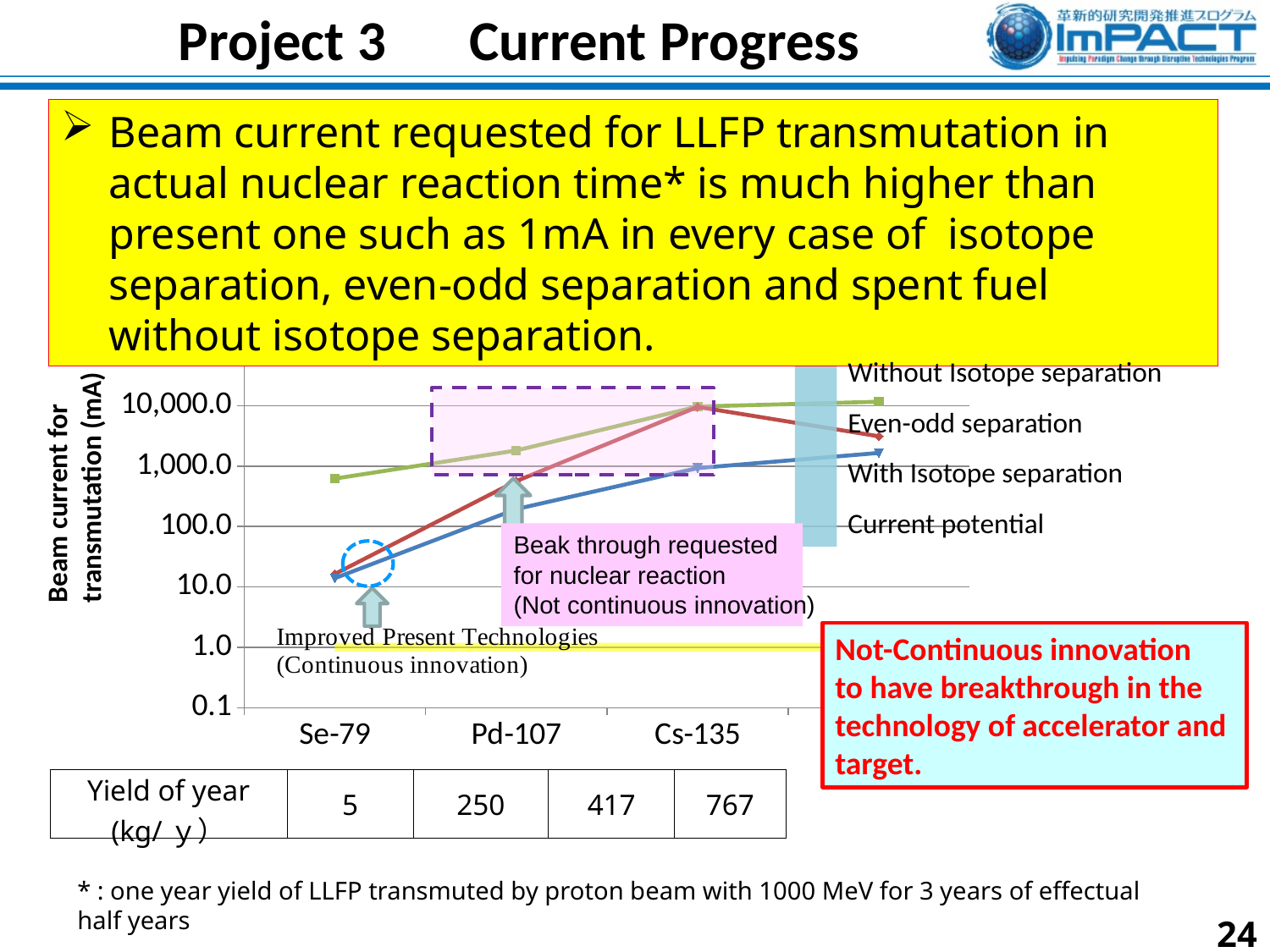
At what beam current level does the Current potential line sit on the chart? 1.0 Is the value for Even-odd separation at Pd-107 greater or less than 100.0? greater What is the label of the chart's vertical axis? Beam current for transmutation (mA) Is the value for Without Isotope separation at Se-79 greater or less than 1,000.0? less Is the value for With Isotope separation at Se-79 greater or less than 100.0? less Does the Without Isotope separation series rise or fall from Se-79 to Cs-135? rise What kind of chart is shown on the slide? line chart How many series does the chart legend list? 4 Which series is listed first in the chart legend? Without Isotope separation